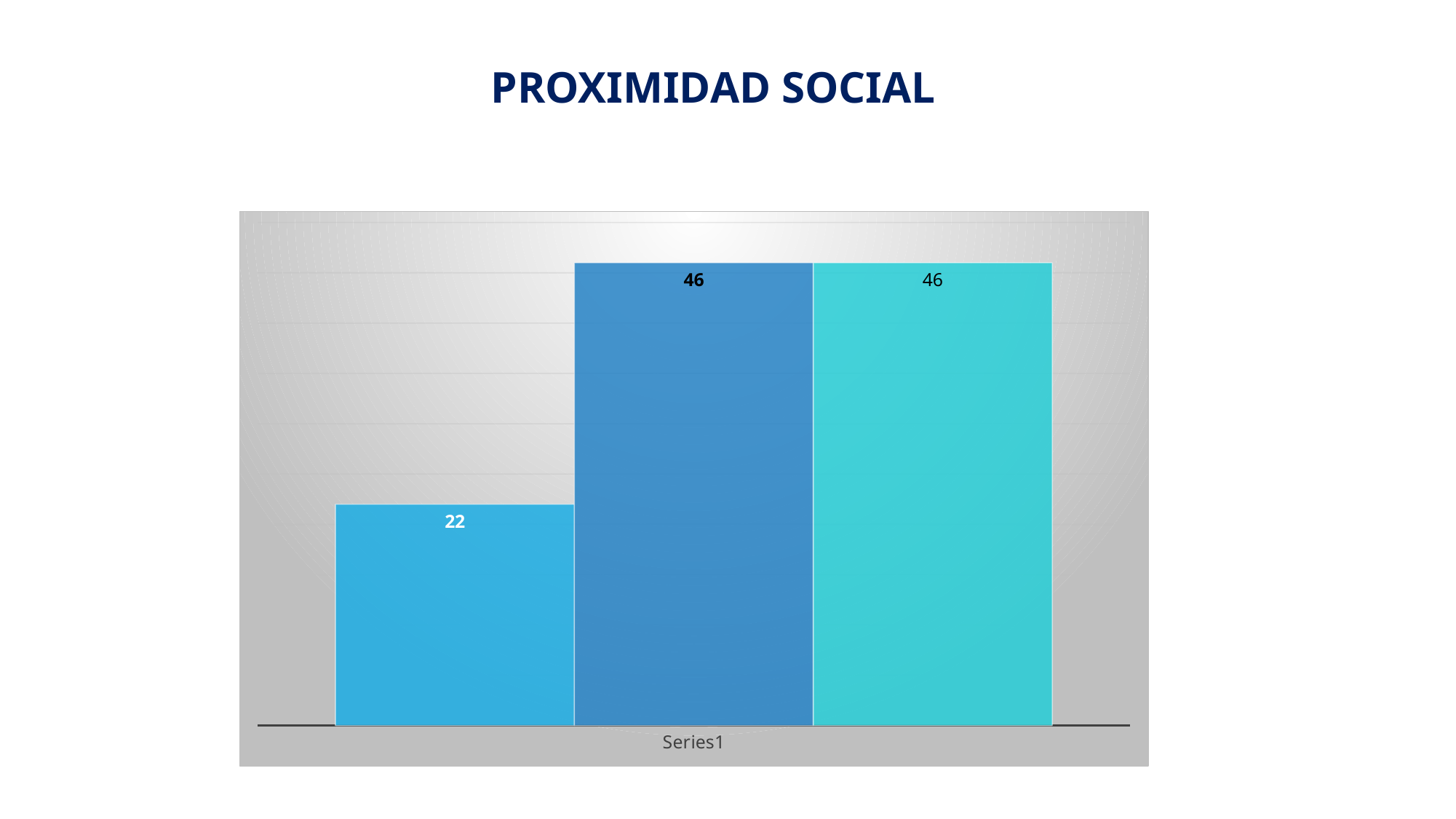
Which is larger, the leftmost bar or the middle bar? the middle bar Which bar has the lowest value? the leftmost (light blue) bar What is the value of the middle (dark blue) bar? 46 What label appears on the x axis below the bars? Series1 What kind of chart is shown on the slide? bar chart What is the value of the rightmost (teal) bar? 46 What is the difference between the middle bar and the leftmost bar? 24 What is the value of the leftmost (light blue) bar? 22 What is the highest value shown in the chart? 46 Which is larger, the middle bar or the rightmost bar? they are equal What is the title of the slide? PROXIMIDAD SOCIAL How many bars are plotted in the chart? 3